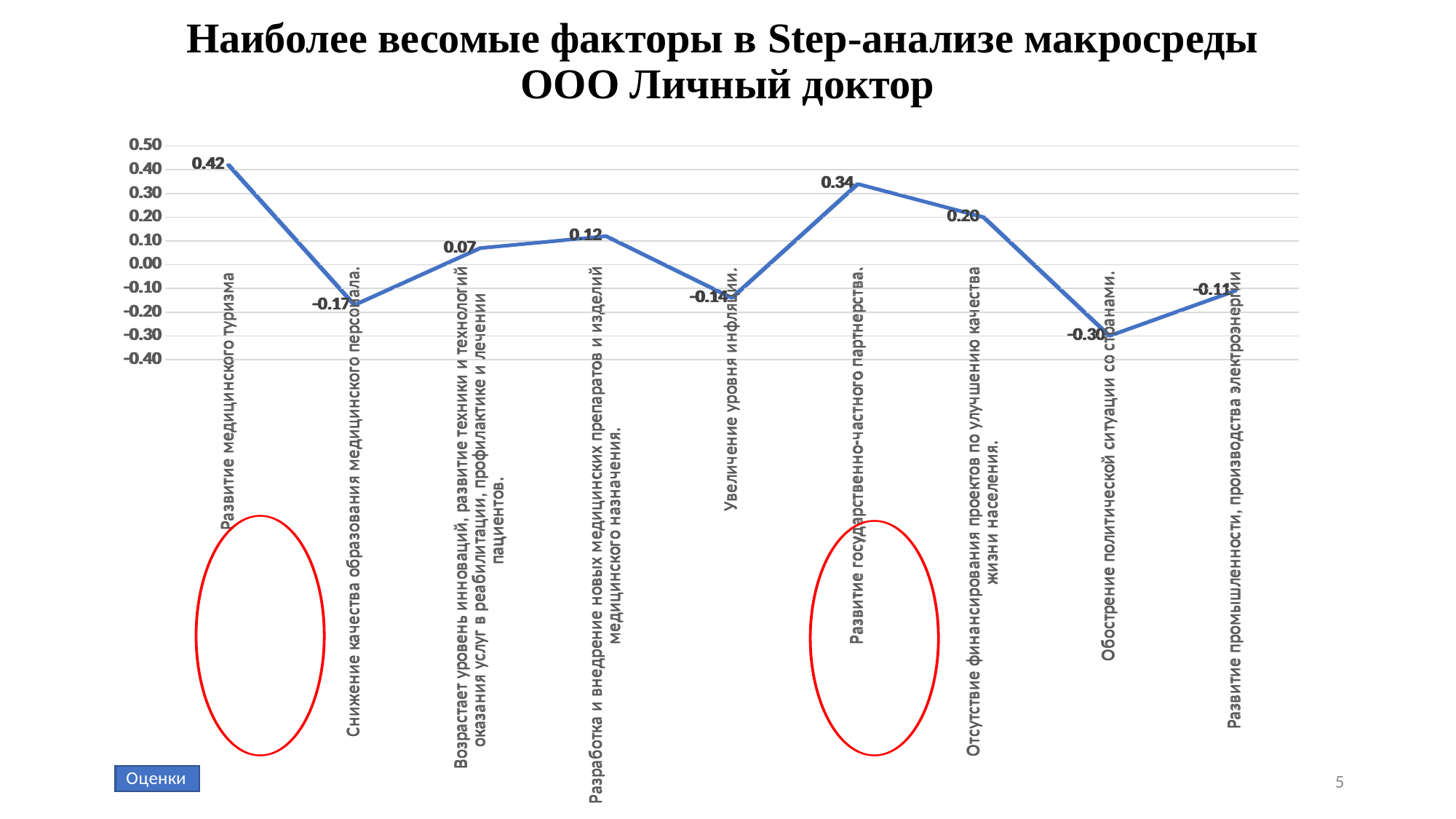
Which is larger: the value for "Разработка и внедрение новых медицинских препаратов и изделий медицинского назначения" or the value for "Возрастает уровень инноваций, развитие техники и технологий оказания услуг в реабилитации, профилактике и лечении пациентов"? Разработка и внедрение новых медицинских препаратов и изделий медицинского назначения What is the value for "Обострение политической ситуации со странами"? -0.30 What is the difference between the values for "Развитие медицинского туризма" and "Развитие государственно-частного партнерства"? 0.08 What is the value for "Увеличение уровня инфляции"? -0.14 What type of chart is shown on the slide? line chart Which factor has the highest value? Развитие медицинского туризма What is the value for "Развитие государственно-частного партнерства"? 0.34 How many factors (categories) are plotted on the chart? 9 What is the value for "Развитие медицинского туризма"? 0.42 Which factor has the lowest value? Обострение политической ситуации со странами